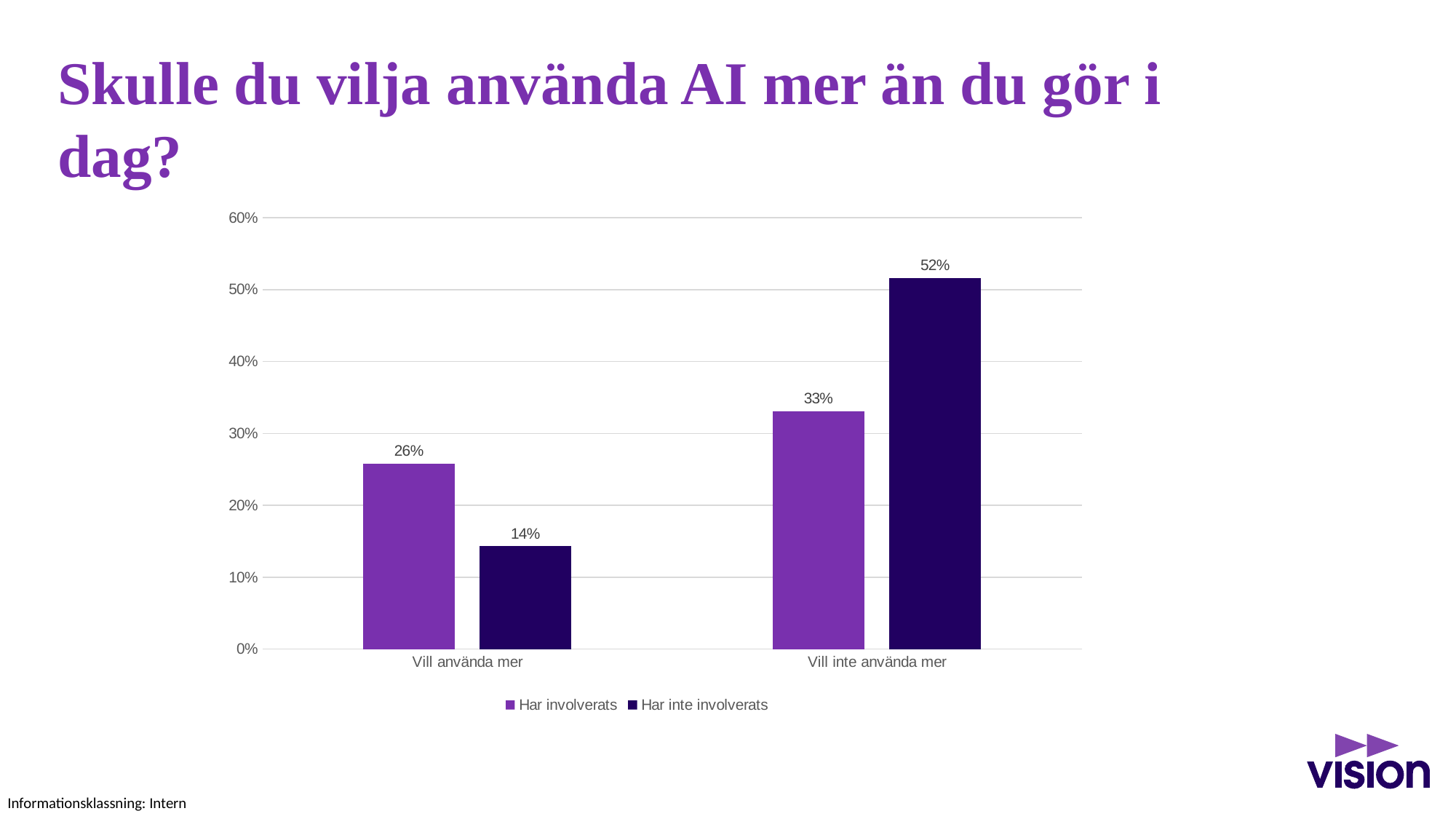
Is the value for "Har inte involverats" in "Vill inte använda mer" greater or less than 50%? greater Which series has the highest value in the chart? Har inte involverats How many series does the legend list? 2 What is the value for "Har involverats" in the "Vill inte använda mer" category? 33% What is the value for "Har inte involverats" in the "Vill inte använda mer" category? 52% What kind of chart is shown on the slide? Bar chart Which category has the lowest value for "Har inte involverats"? Vill använda mer How many categories are shown on the x axis? 2 What is the difference between "Har inte involverats" and "Har involverats" in the "Vill inte använda mer" category? 19% In the "Vill använda mer" category, which series has the larger value? Har involverats What is the value for "Har involverats" in the "Vill använda mer" category? 26% What is the value for "Har inte involverats" in the "Vill använda mer" category? 14%